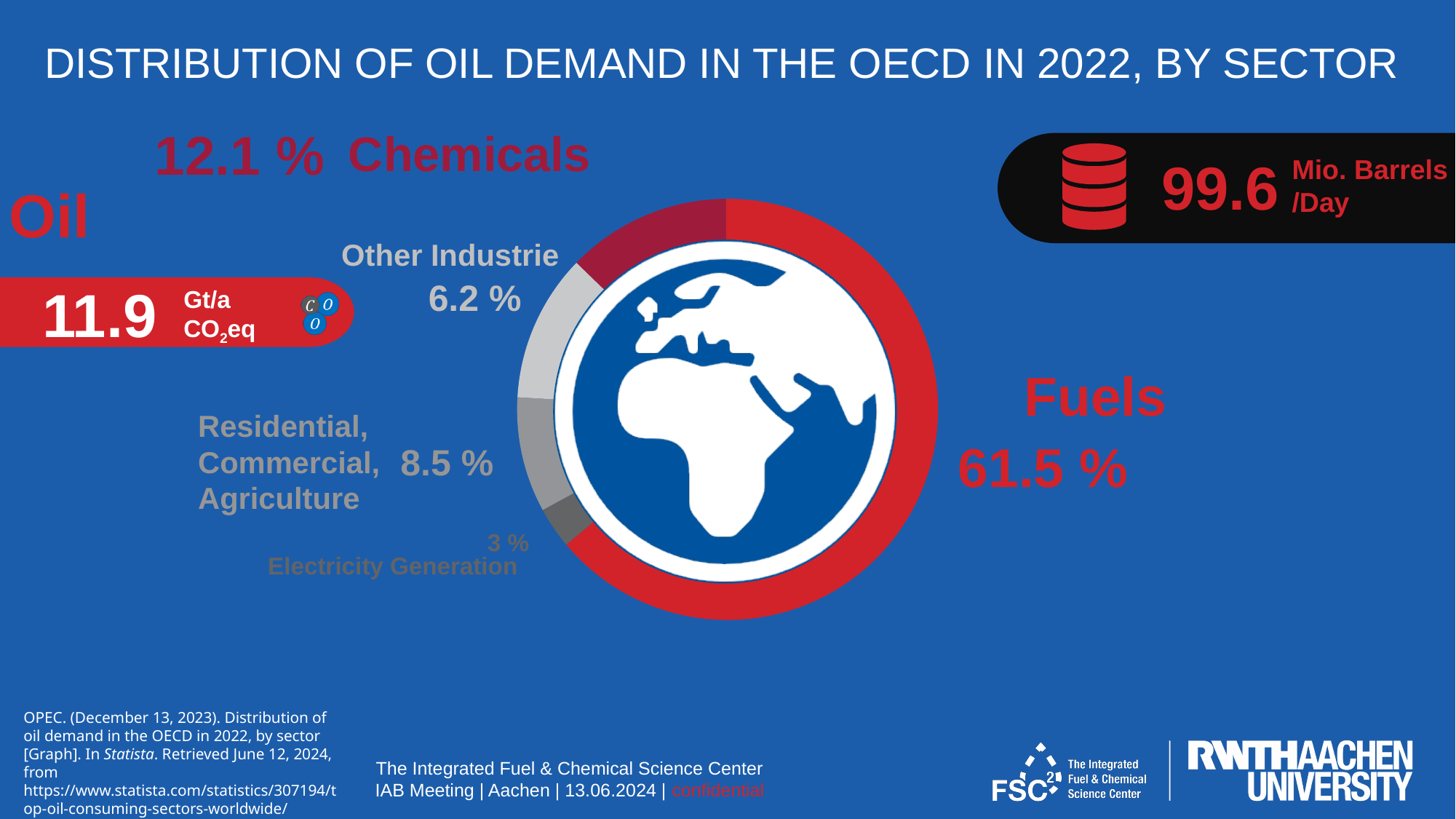
Which sector has the largest share of OECD oil demand in 2022? Fuels What kind of chart is used to show the distribution of oil demand by sector? Pie chart (donut) What is the oil demand figure shown in million barrels per day on the slide? 99.6 How many percentage points larger is the Fuels share than the Chemicals share? 49.4 % Which sector has the smallest share of OECD oil demand in 2022? Electricity Generation What share of OECD oil demand in 2022 is attributed to Other Industrie? 6.2 % How many sectors are shown in the chart? 5 What share of OECD oil demand in 2022 is attributed to Residential, Commercial, Agriculture? 8.5 % What share of OECD oil demand in 2022 is attributed to Fuels? 61.5 % Which sector has a larger share: Chemicals or Residential, Commercial, Agriculture? Chemicals What share of OECD oil demand in 2022 is attributed to Chemicals? 12.1 % What share of OECD oil demand in 2022 is attributed to Electricity Generation? 3 %